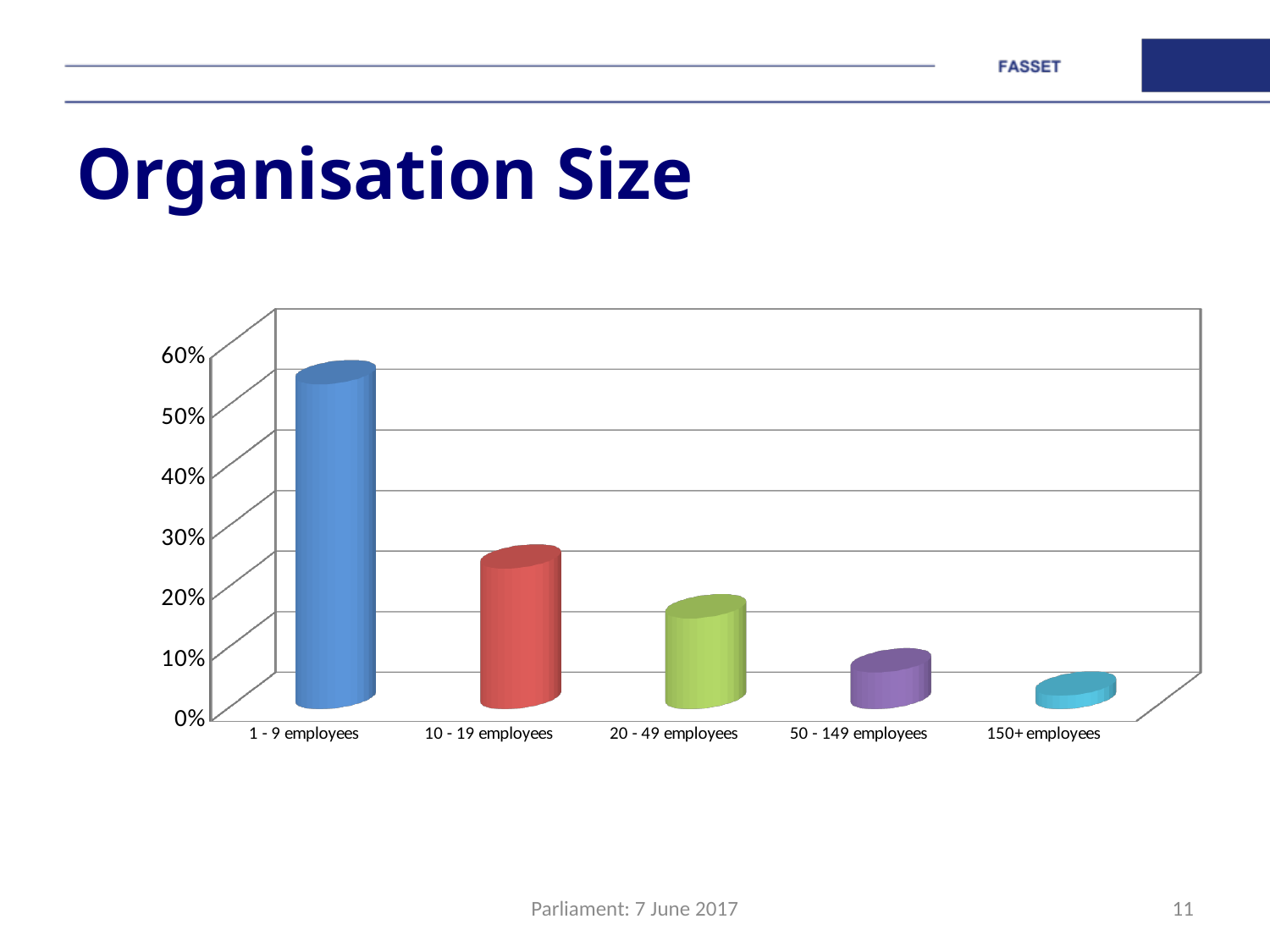
Do the values rise or fall as organisation size increases along the x axis? Fall Which organisation size category has the highest value? 1 - 9 employees Is the value for 50 - 149 employees greater or less than 10%? less What kind of chart is shown on the slide? Bar chart What is the title of the slide containing the chart? Organisation Size Is the value for 20 - 49 employees greater or less than 20%? less Is the value for 150+ employees greater or less than 10%? less Which is larger, the value for 10 - 19 employees or the value for 20 - 49 employees? 10 - 19 employees Which organisation size category has the lowest value? 150+ employees How many organisation size categories are shown on the x axis? 5